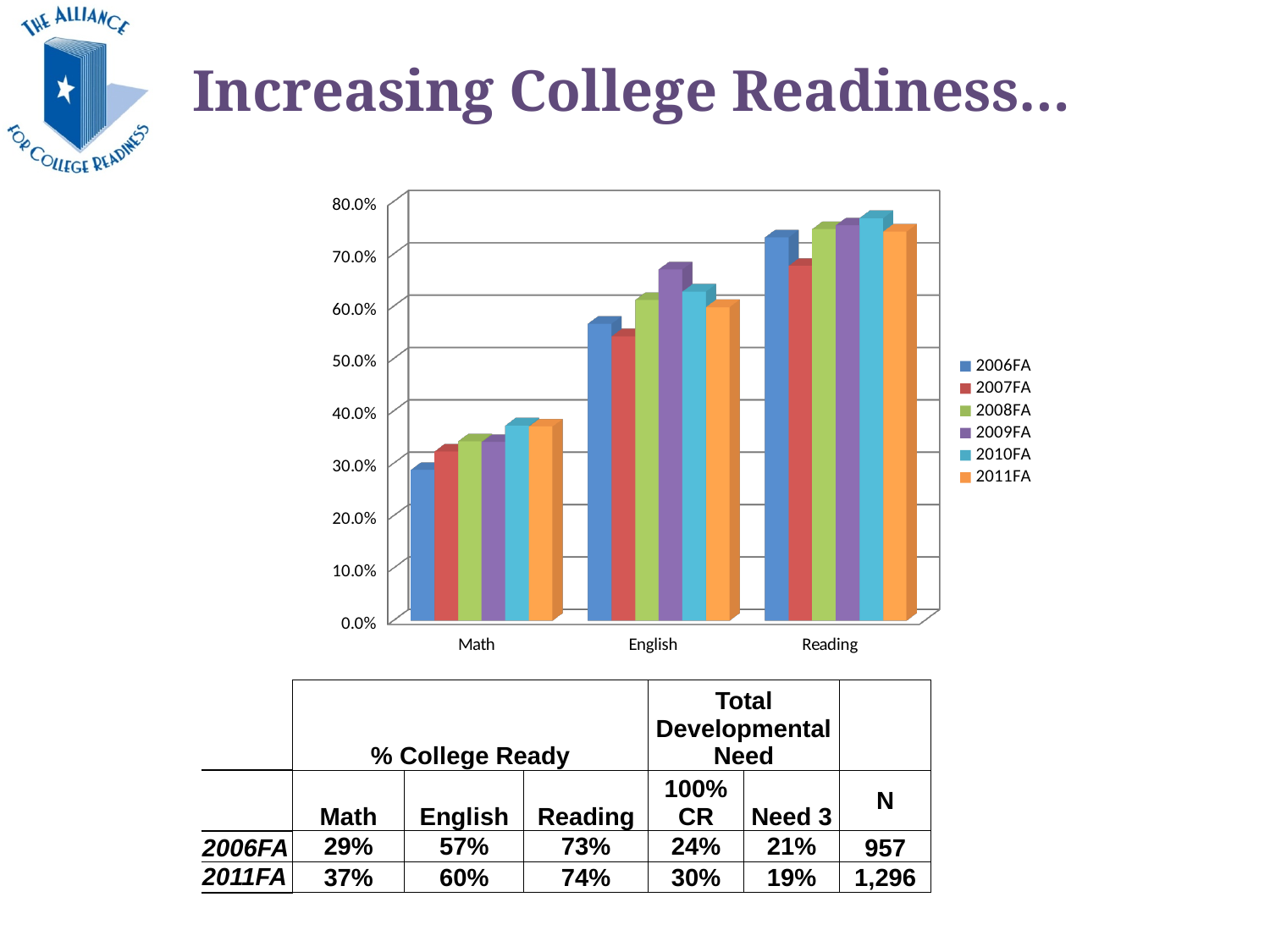
Which series is shown in orange in the chart legend? 2011FA Which category has the lowest values in the chart? Math Is the value for 2006FA in Math greater or less than 40.0%? less Is the value for 2009FA in English greater or less than 60.0%? greater Is the value for 2007FA in Reading greater or less than 70.0%? less According to the table below the chart, what is the % College Ready value for Reading in 2006FA? 73% What type of chart is shown on the slide? bar chart In the English category, which is larger: the 2009FA bar or the 2007FA bar? 2009FA Which category has the highest values in the chart? Reading How many categories are shown on the x axis of the chart? 3 How many series does the chart legend list? 6 According to the table below the chart, what is the % College Ready value for Math in 2011FA? 37%